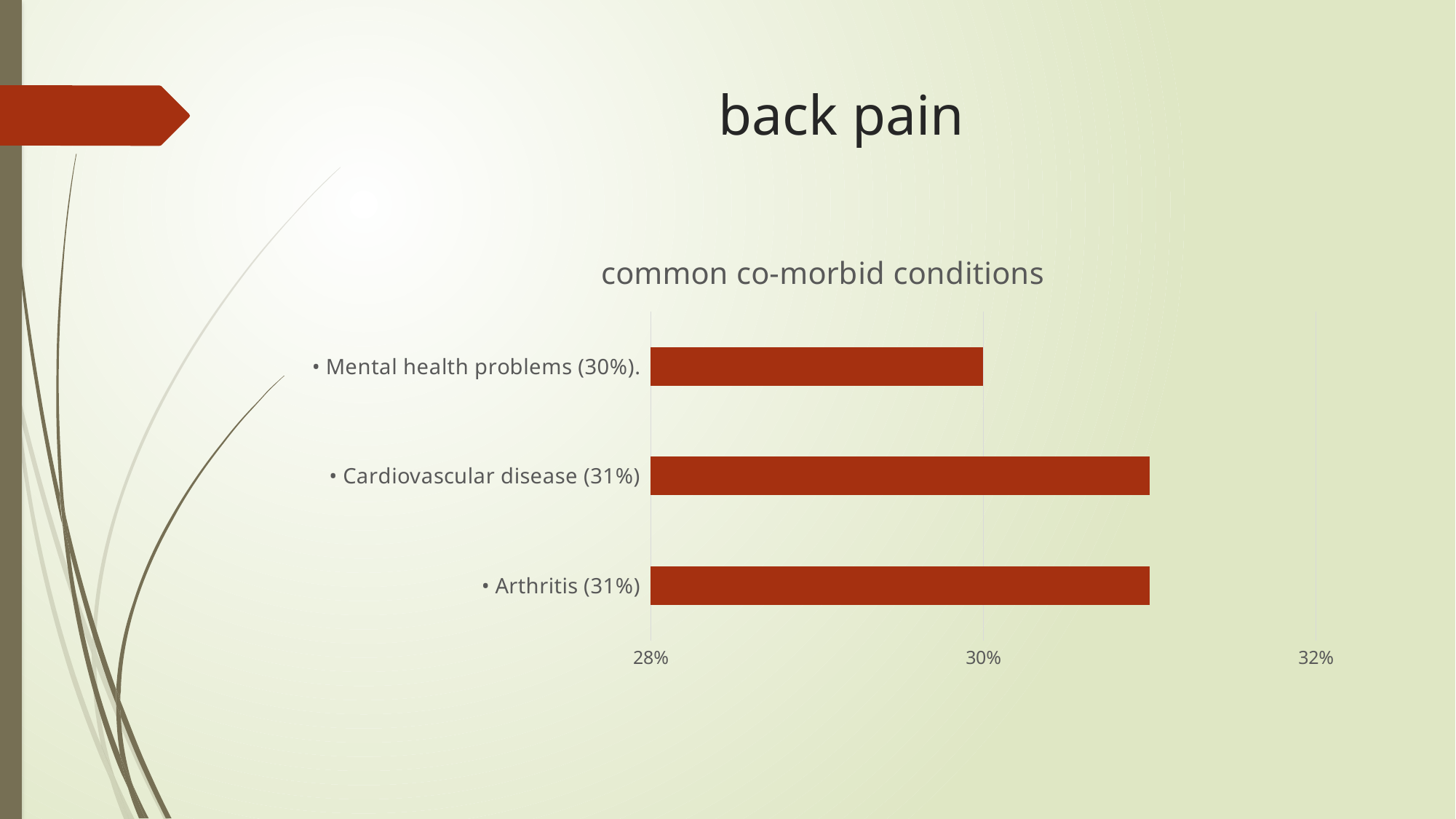
What is the difference between the values for Cardiovascular disease and Mental health problems? 1% What kind of chart is shown on the slide? bar chart Which category has the lowest value in the common co-morbid conditions chart? Mental health problems Is the value for Arthritis greater or less than 30%? greater How many categories are shown in the common co-morbid conditions chart? 3 What is the value for Mental health problems in the common co-morbid conditions chart? 30% What is the value for Cardiovascular disease in the common co-morbid conditions chart? 31% Is the value for Cardiovascular disease greater or less than 32%? less What is the value for Arthritis in the common co-morbid conditions chart? 31% What is the title of the chart on the slide? common co-morbid conditions Which is larger, the value for Arthritis or the value for Mental health problems? Arthritis What is the highest value shown on the horizontal axis of the chart? 32%